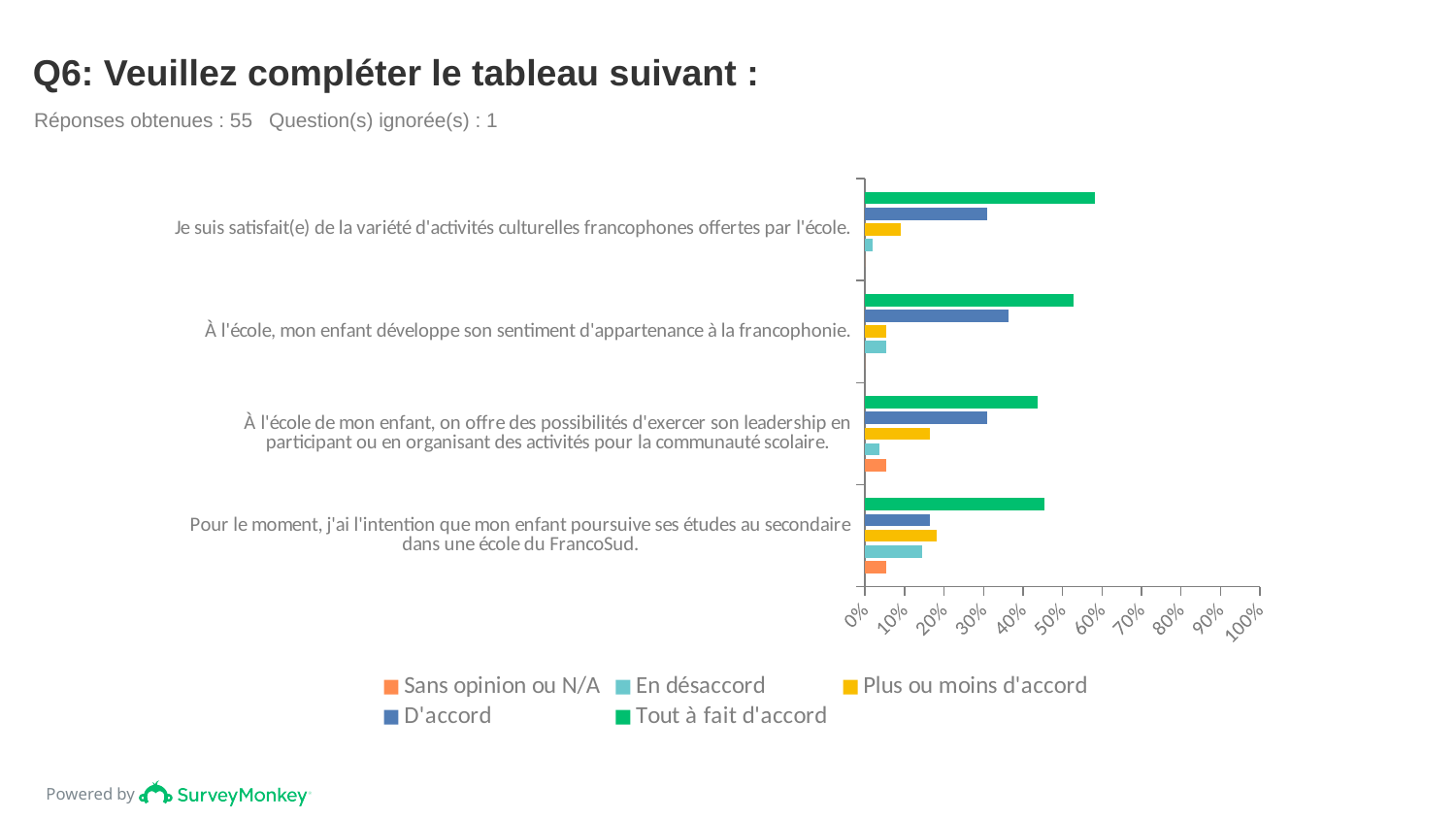
Which statement has the highest 'Tout à fait d'accord' value? Je suis satisfait(e) de la variété d'activités culturelles francophones offertes par l'école. Is the 'Tout à fait d'accord' value for the statement about leadership opportunities greater or less than 40%? greater Is the 'Plus ou moins d'accord' value for the statement about leadership opportunities greater or less than 20%? less Is the 'En désaccord' value for the statement about continuing secondary studies in a FrancoSud school greater or less than 10%? greater What kind of chart is shown on the slide? bar chart How many series does the legend list? 5 How many statements (categories) are plotted on the chart? 4 For the statement 'À l'école, mon enfant développe son sentiment d'appartenance à la francophonie.', which is larger: 'Tout à fait d'accord' or 'D'accord'? Tout à fait d'accord For the statement 'Pour le moment, j'ai l'intention que mon enfant poursuive ses études au secondaire dans une école du FrancoSud.', which is larger: 'Tout à fait d'accord' or 'D'accord'? Tout à fait d'accord What colour represents 'Tout à fait d'accord' in the legend? green